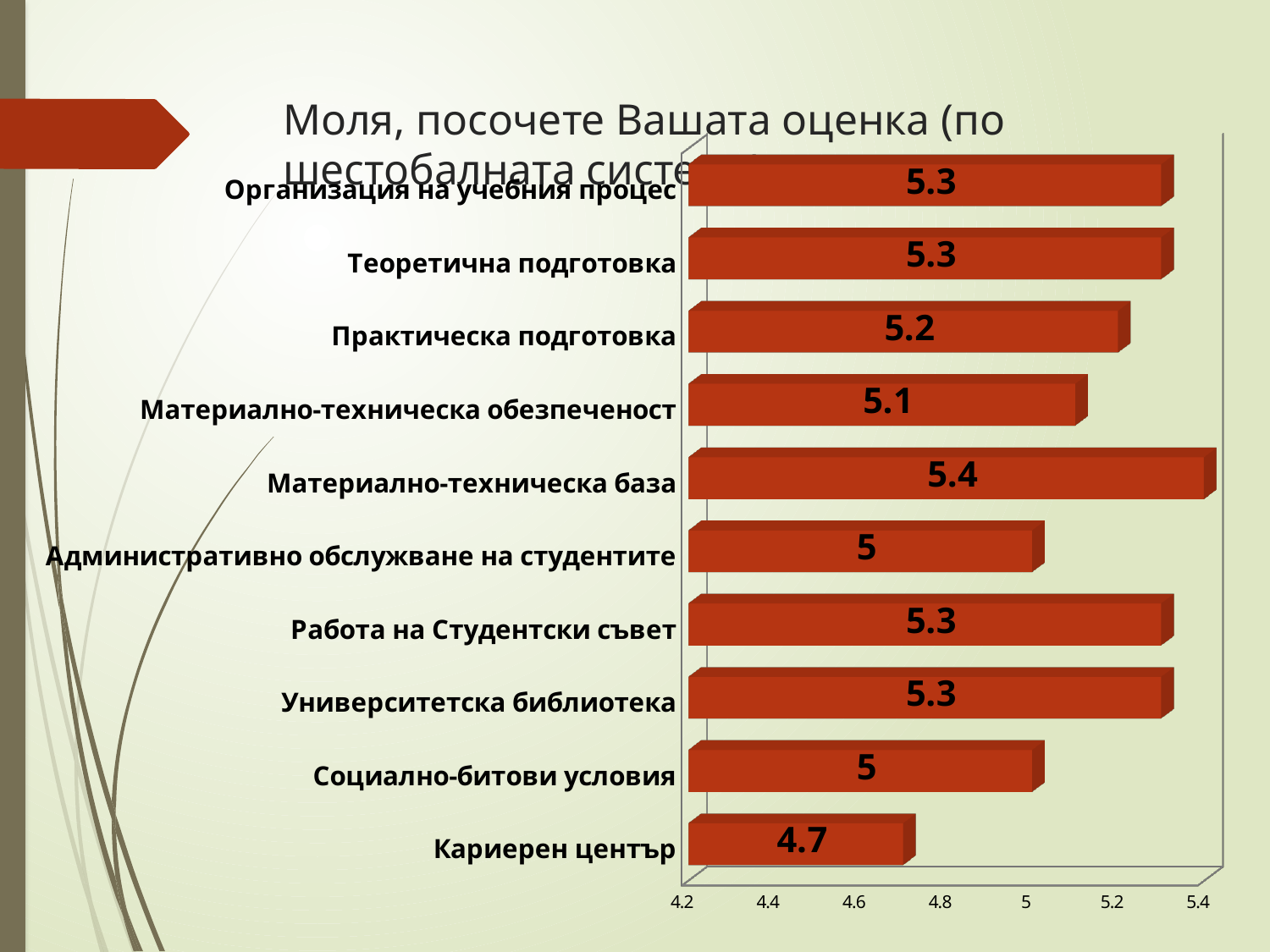
What kind of chart is shown on the slide? bar chart What is the difference between the values for Материално-техническа база and Кариерен център? 0.7 Is the value for Кариерен център greater or less than 4.8? less What is the value for Практическа подготовка? 5.2 How many categories are shown in the chart? 10 Which category has the lowest value? Кариерен център What is the value for Кариерен център? 4.7 Which is larger, the value for Практическа подготовка or the value for Материално-техническа обезпеченост? Практическа подготовка What is the difference between the values for Теоретична подготовка and Социално-битови условия? 0.3 Which category has the highest value? Материално-техническа база What is the value for Административно обслужване на студентите? 5 What is the value for Материално-техническа база? 5.4